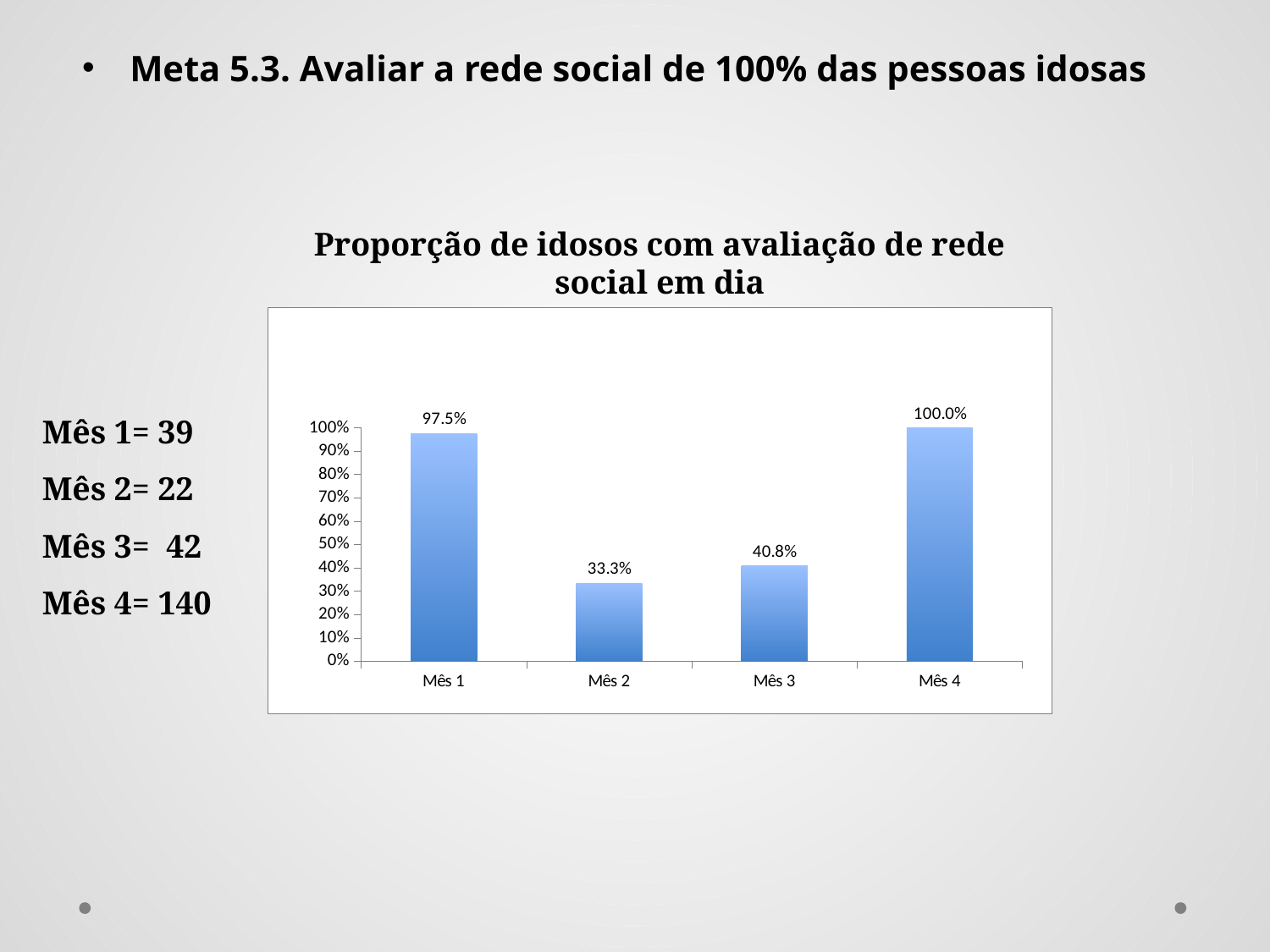
What is the difference between the values for Mês 3 and Mês 2? 7.5% What is the value for Mês 4? 100.0% Which is larger, the value for Mês 3 or the value for Mês 2? Mês 3 What kind of chart is shown? Bar chart Which month has the highest value? Mês 4 What is the value for Mês 1? 97.5% What is the difference between the values for Mês 1 and Mês 2? 64.2% Which month has the lowest value? Mês 2 What is the value for Mês 3? 40.8% How many months are shown on the x axis? 4 What is the title of the chart? Proporção de idosos com avaliação de rede social em dia What is the value for Mês 2? 33.3%